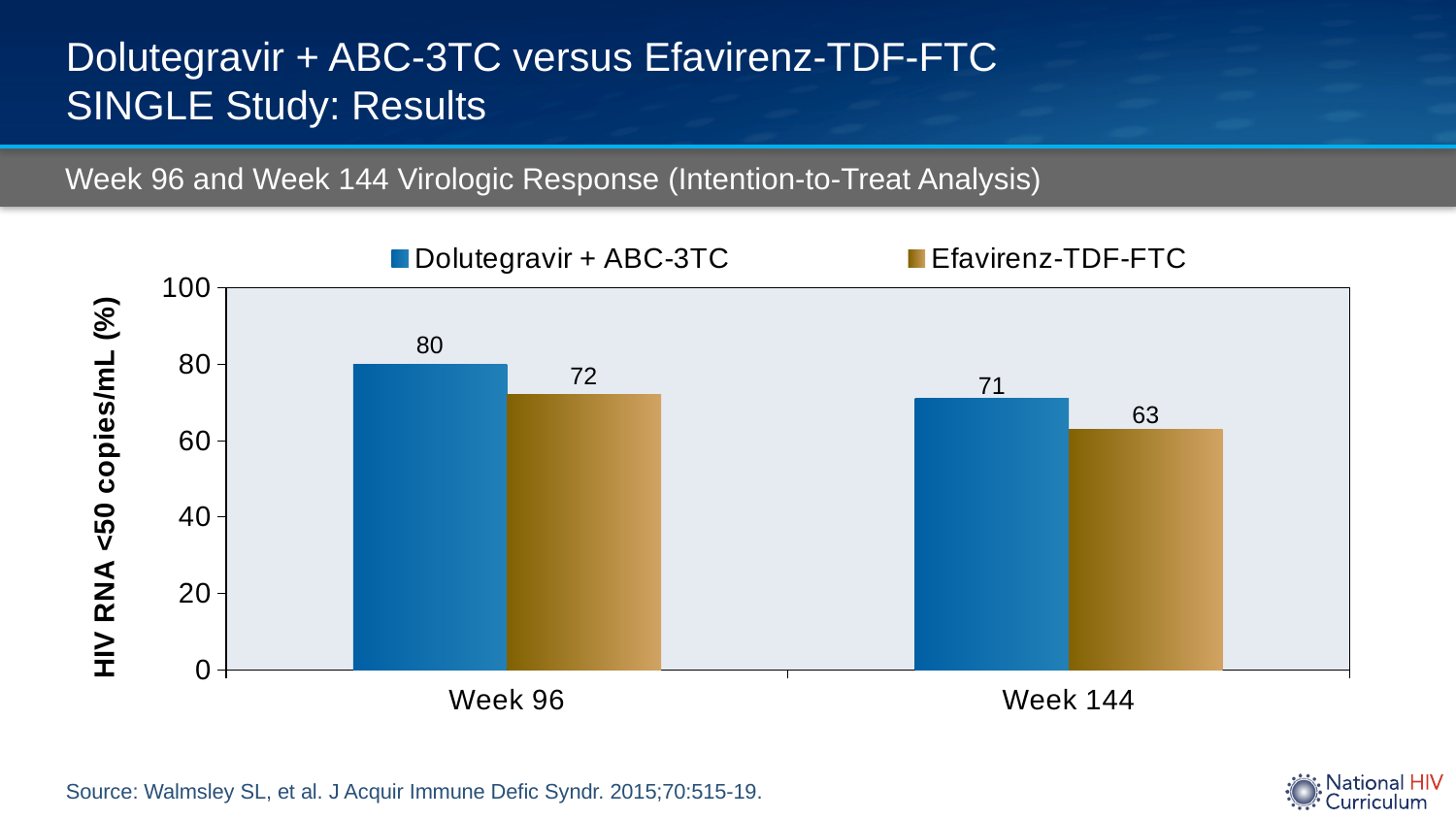
Does the value for Dolutegravir + ABC-3TC rise or fall from Week 96 to Week 144? Fall Which is larger at Week 96: Dolutegravir + ABC-3TC or Efavirenz-TDF-FTC? Dolutegravir + ABC-3TC What is the value for Efavirenz-TDF-FTC at Week 96? 72 What is the value for Efavirenz-TDF-FTC at Week 144? 63 Is the value for Efavirenz-TDF-FTC at Week 144 greater or less than 80? less What is the value for Dolutegravir + ABC-3TC at Week 96? 80 Which bar has the lowest value on the chart? Efavirenz-TDF-FTC at Week 144 Which bar has the highest value on the chart? Dolutegravir + ABC-3TC at Week 96 What is the difference between Dolutegravir + ABC-3TC and Efavirenz-TDF-FTC at Week 144? 8 What kind of chart is shown on the slide? Bar chart How many time points are shown on the x axis? 2 How many series does the legend list? 2